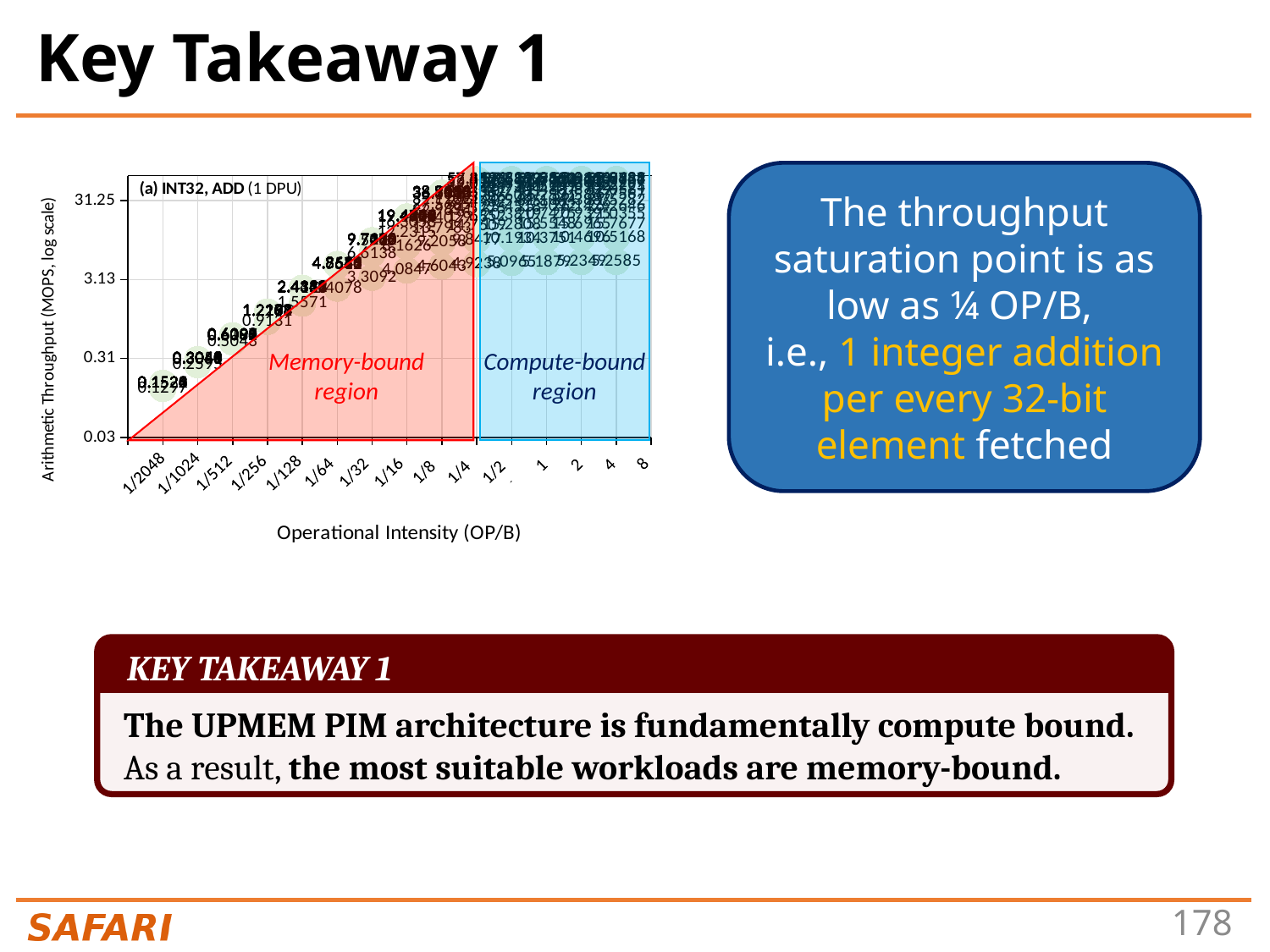
What is the title printed inside the chart? (a) INT32, ADD (1 DPU) How does arithmetic throughput change as operational intensity increases from 1/2048 to 1/4? It rises What are the two shaded regions in the chart labelled? Memory-bound region and Compute-bound region How many operational intensity values are marked on the x axis? 15 Which has the higher arithmetic throughput: operational intensity 1/2048 or 8? 8 Which has the higher arithmetic throughput: operational intensity 1/256 or 1/32? 1/32 Is the arithmetic throughput at operational intensity 1/64 greater or less than 0.31 MOPS? greater At which operational intensity is the arithmetic throughput lowest? 1/2048 Is the arithmetic throughput at operational intensity 1/2048 greater or less than 0.31 MOPS? less Is the arithmetic throughput at operational intensity 8 greater or less than 3.13 MOPS? greater What kind of chart is shown on the slide? scatter chart